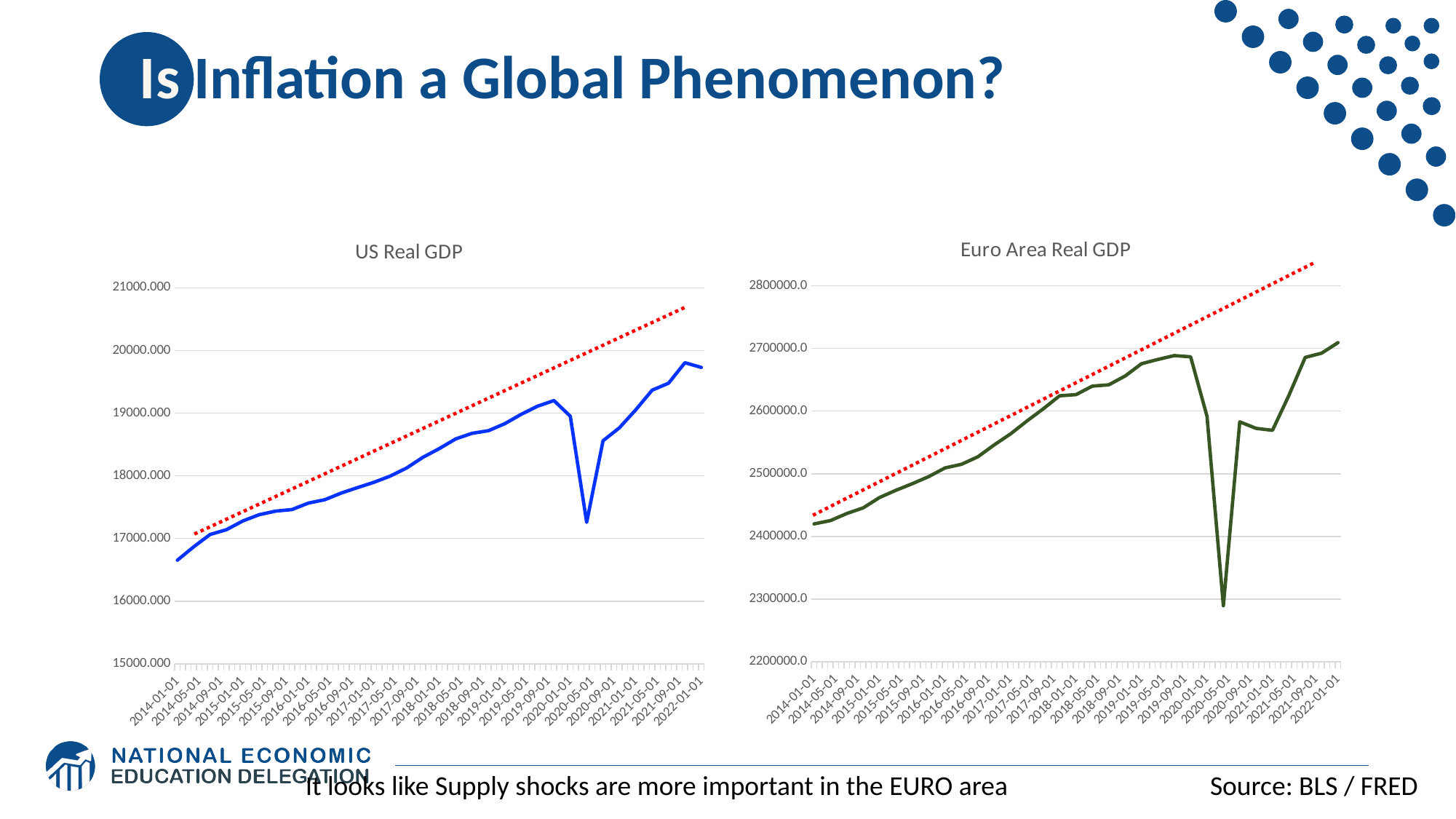
In the Euro Area Real GDP chart, in which year does the sharp drop in the line occur? 2020 What kind of chart is the US Real GDP chart? line chart In the US Real GDP chart, is the value at 2014-01-01 greater or less than 17000.000? less In the US Real GDP chart, is the lowest point of the sharp dip greater or less than 18000.000? less In the Euro Area Real GDP chart, is the value at 2014-01-01 greater or less than 2500000.0? less In the US Real GDP chart, which is larger: the value at 2019-09-01 or the value at 2014-09-01? 2019-09-01 What is the title of the chart on the right side of the slide? Euro Area Real GDP What colour is the dotted trend line in both charts? red In the US Real GDP chart, does the line generally rise or fall from 2014-01-01 to 2022-01-01? rise